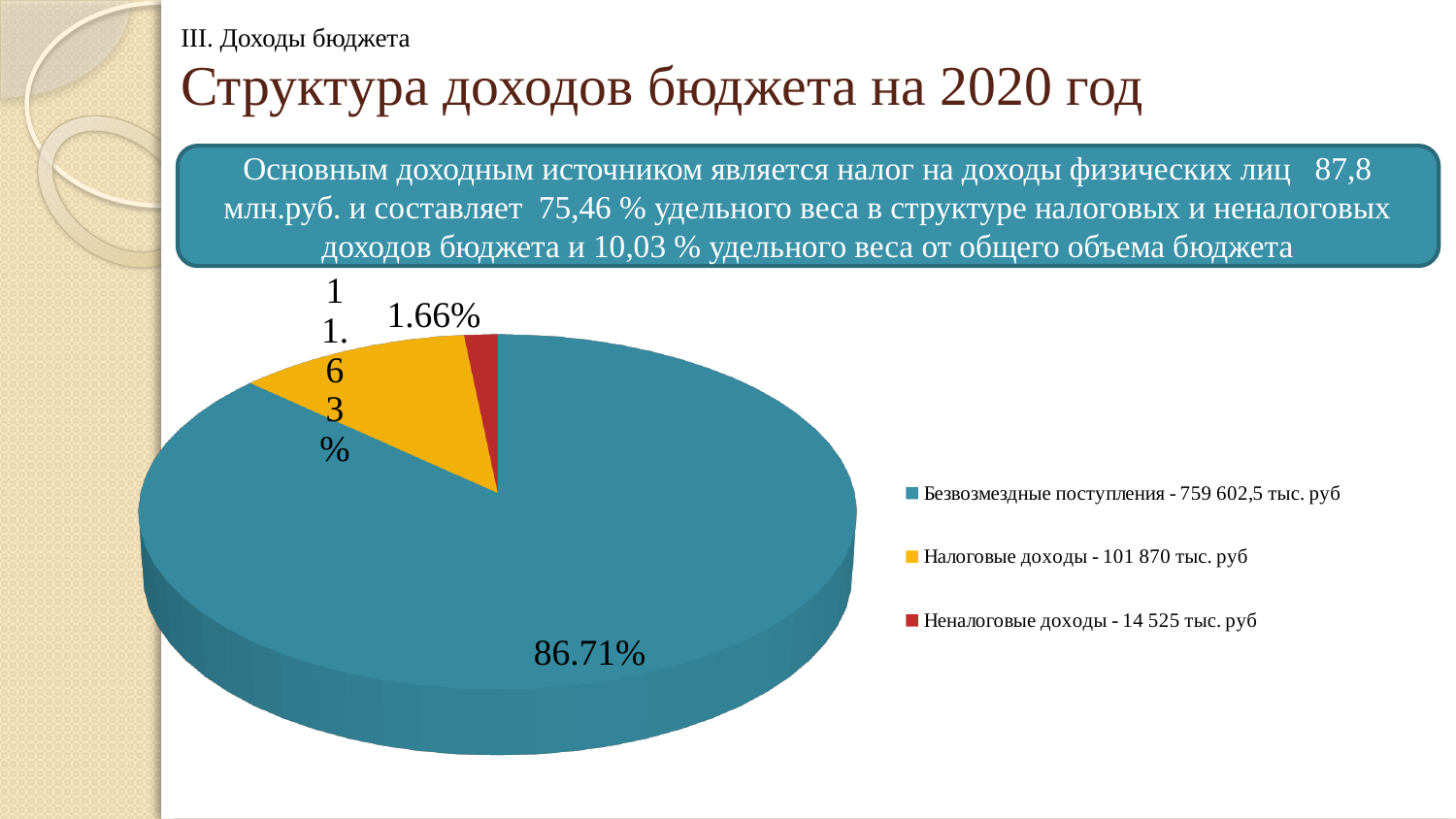
What amount in тыс. руб does the legend give for Налоговые доходы? 101 870 тыс. руб What kind of chart is shown on the slide? pie chart What share of the pie does Налоговые доходы take? 11.63% What share of the pie does Неналоговые доходы take? 1.66% What share of the pie does Безвозмездные поступления take? 86.71% Which category has the smallest slice of the pie? Неналоговые доходы What is the difference in percentage points between the Безвозмездные поступления slice and the Неналоговые доходы slice? 85.05 Which is larger: the slice for Налоговые доходы or the slice for Неналоговые доходы? Налоговые доходы How many entries does the legend of the pie chart list? 3 What colour is the slice for Неналоговые доходы? red Which category has the largest slice of the pie? Безвозмездные поступления How many slices does the pie chart have? 3